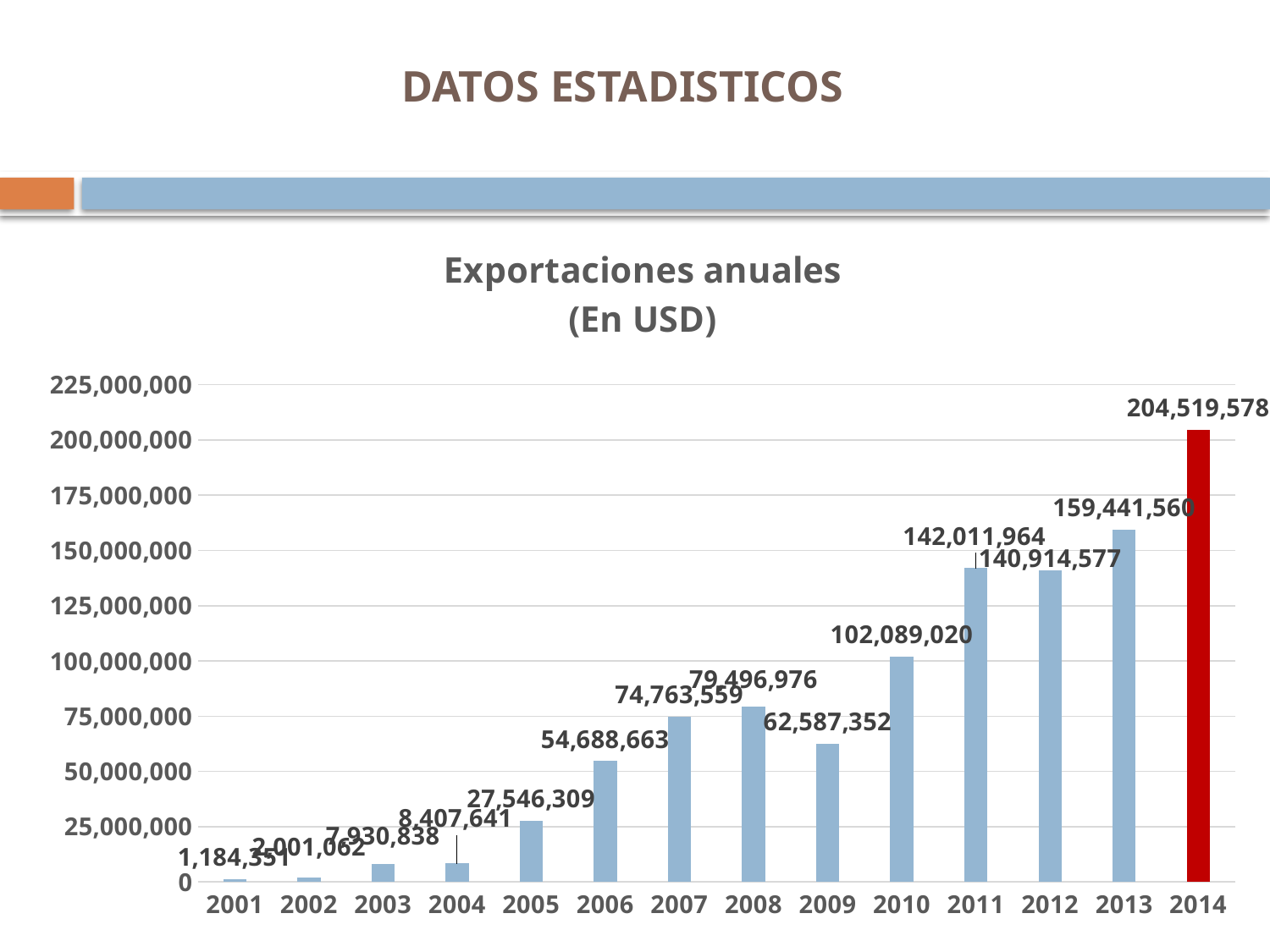
What kind of chart is the Exportaciones anuales chart? bar chart How many years are shown on the x axis of the Exportaciones anuales chart? 14 Do the values in the Exportaciones anuales chart generally rise or fall from 2001 to 2014? rise What is the difference between the values for 2014 and 2013 in the Exportaciones anuales chart? 45,078,018 Which year has the lowest value in the Exportaciones anuales chart? 2001 Which year has the larger value in the Exportaciones anuales chart, 2008 or 2009? 2008 What is the value for 2014 in the Exportaciones anuales chart? 204,519,578 What colour is the bar for 2014 in the Exportaciones anuales chart? red What is the value for 2006 in the Exportaciones anuales chart? 54,688,663 What is the value for 2010 in the Exportaciones anuales chart? 102,089,020 Is the value for 2010 in the Exportaciones anuales chart greater or less than 100,000,000? greater Which year has the highest value in the Exportaciones anuales chart? 2014